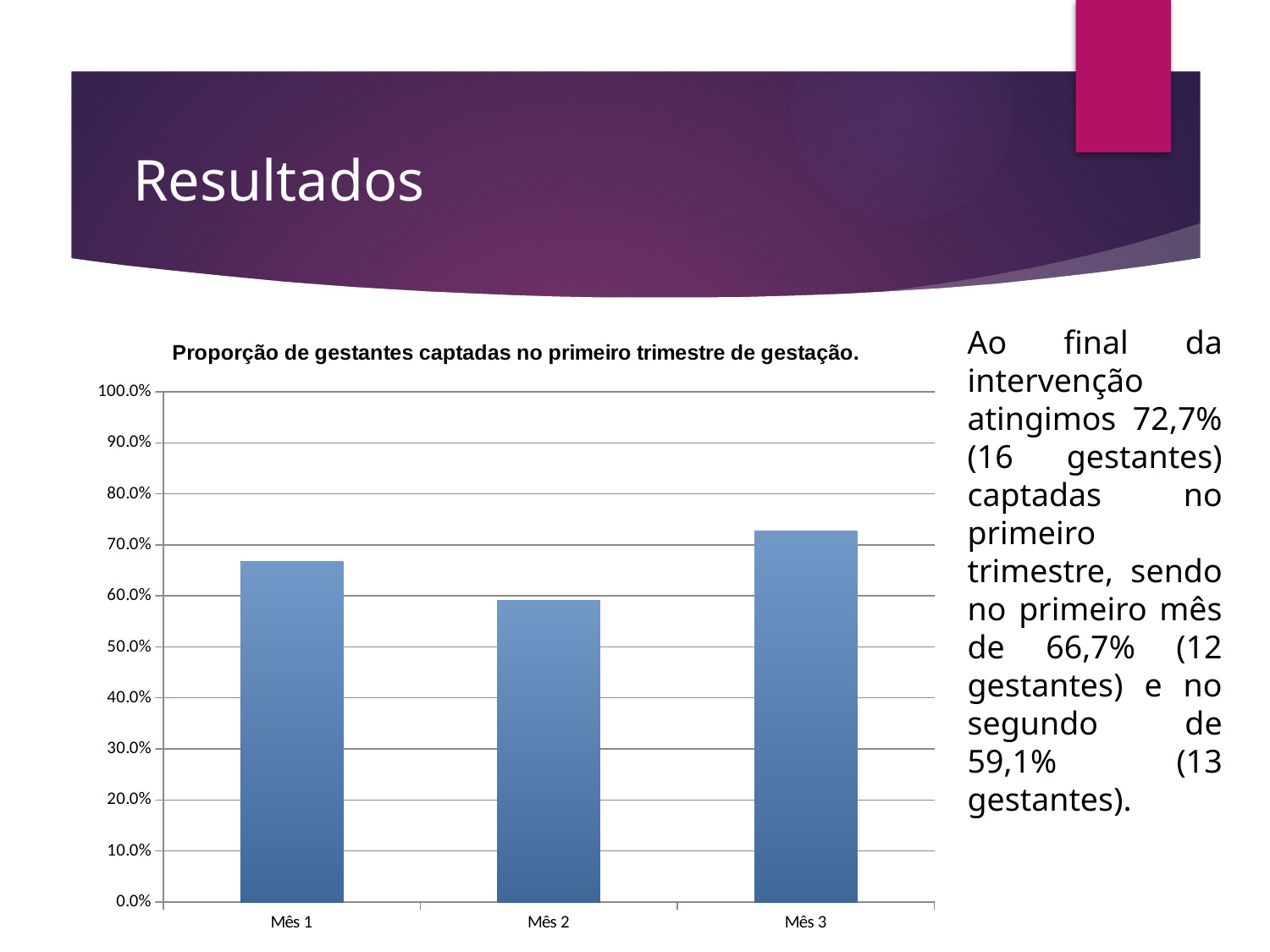
Is the value for Mês 3 greater or less than 80.0%? less Which is larger, the value for Mês 1 or the value for Mês 2? Mês 1 Which is larger, the value for Mês 1 or the value for Mês 3? Mês 3 Which month has the highest proportion in the chart? Mês 3 Is the value for Mês 2 greater or less than 50.0%? greater How many categories (months) are plotted on the chart? 3 Does the value rise or fall from Mês 2 to Mês 3? rise What is the title of the chart? Proporção de gestantes captadas no primeiro trimestre de gestação. Is the value for Mês 1 greater or less than 60.0%? greater Which month has the lowest proportion in the chart? Mês 2 What kind of chart is shown on the slide? bar chart What is the maximum value shown on the vertical axis of the chart? 100.0%